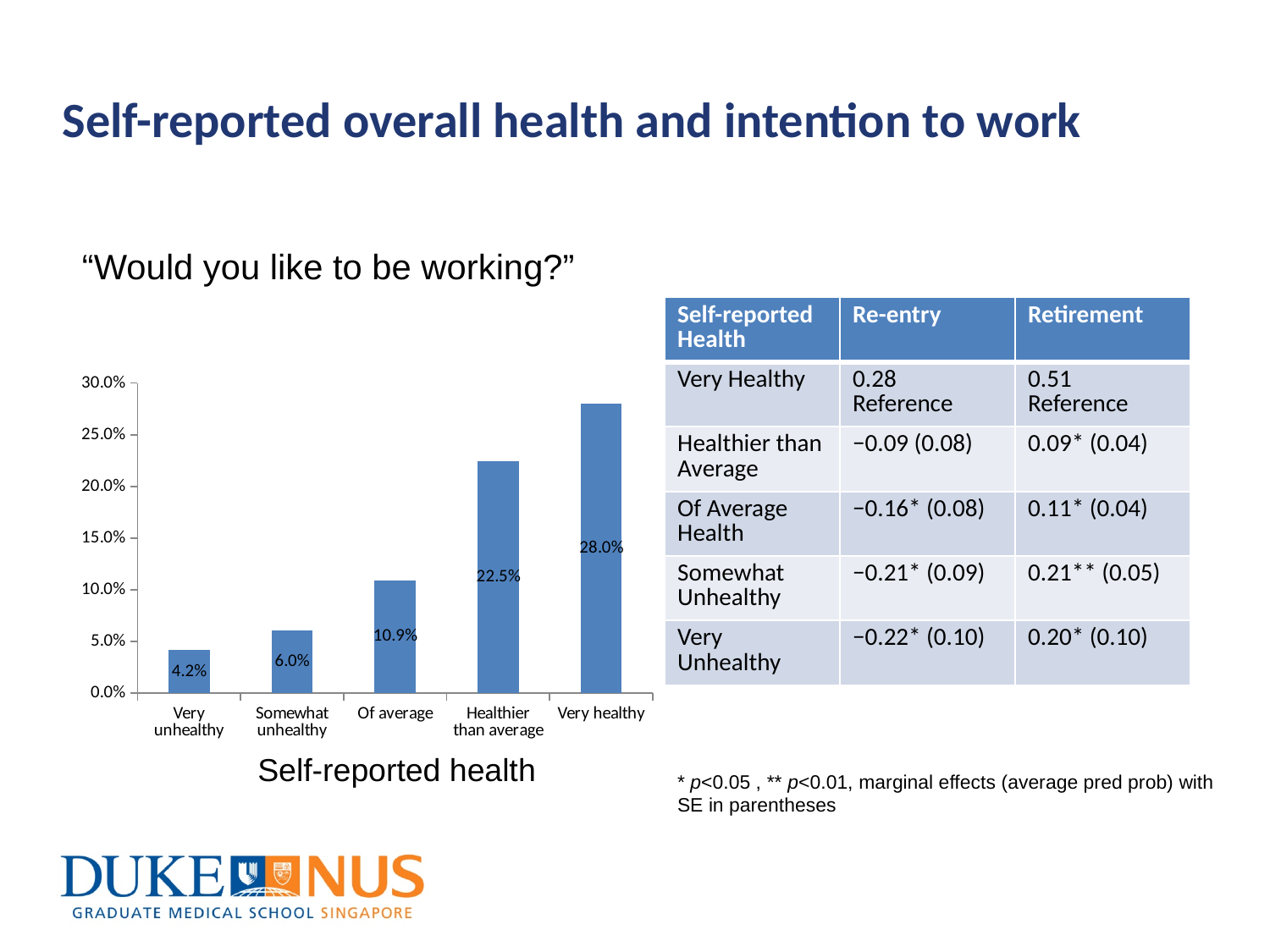
What is the difference between the values for "Somewhat unhealthy" and "Very unhealthy"? 1.8% What is the value for "Healthier than average" in the bar chart? 22.5% What kind of chart is shown on the slide? Bar chart Do the values rise or fall moving from "Very unhealthy" to "Very healthy" along the x axis? Rise Is the value for "Healthier than average" greater or less than 20.0%? greater What is the value for "Very unhealthy" in the bar chart? 4.2% Which category has the lowest value in the bar chart? Very unhealthy What is the value for "Of average" in the bar chart? 10.9% Which is larger, the value for "Of average" or the value for "Somewhat unhealthy"? Of average What is the difference between the values for "Very healthy" and "Healthier than average"? 5.5% Which category has the highest value in the bar chart? Very healthy How many categories are shown on the x axis of the bar chart? 5